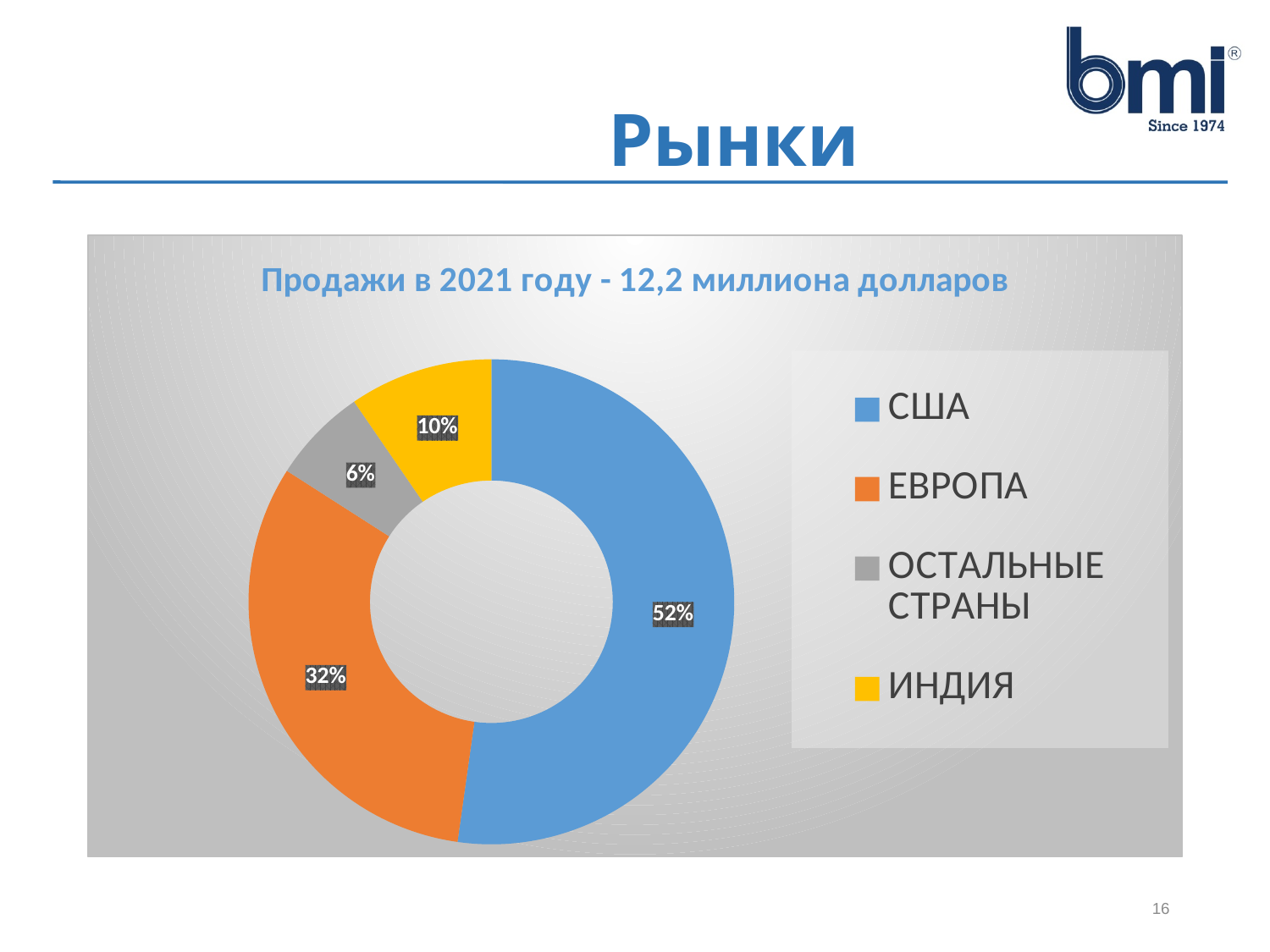
What is the difference in percentage points between the shares of США and ЕВРОПА? 20 What share of 2021 sales does ЕВРОПА (Europe) account for? 32% What share of 2021 sales does США (USA) account for? 52% What colour represents ЕВРОПА in the chart? Orange What kind of chart is shown on the slide? Doughnut (pie) chart How many markets are shown in the chart? 4 What share of 2021 sales does ИНДИЯ (India) account for? 10% What share of 2021 sales do ОСТАЛЬНЫЕ СТРАНЫ (other countries) account for? 6% Which market has the smallest share of 2021 sales? ОСТАЛЬНЫЕ СТРАНЫ Which has a larger share of 2021 sales, ИНДИЯ or ОСТАЛЬНЫЕ СТРАНЫ? ИНДИЯ Which market has the largest share of 2021 sales? США What is the title of the chart? Продажи в 2021 году - 12,2 миллиона долларов